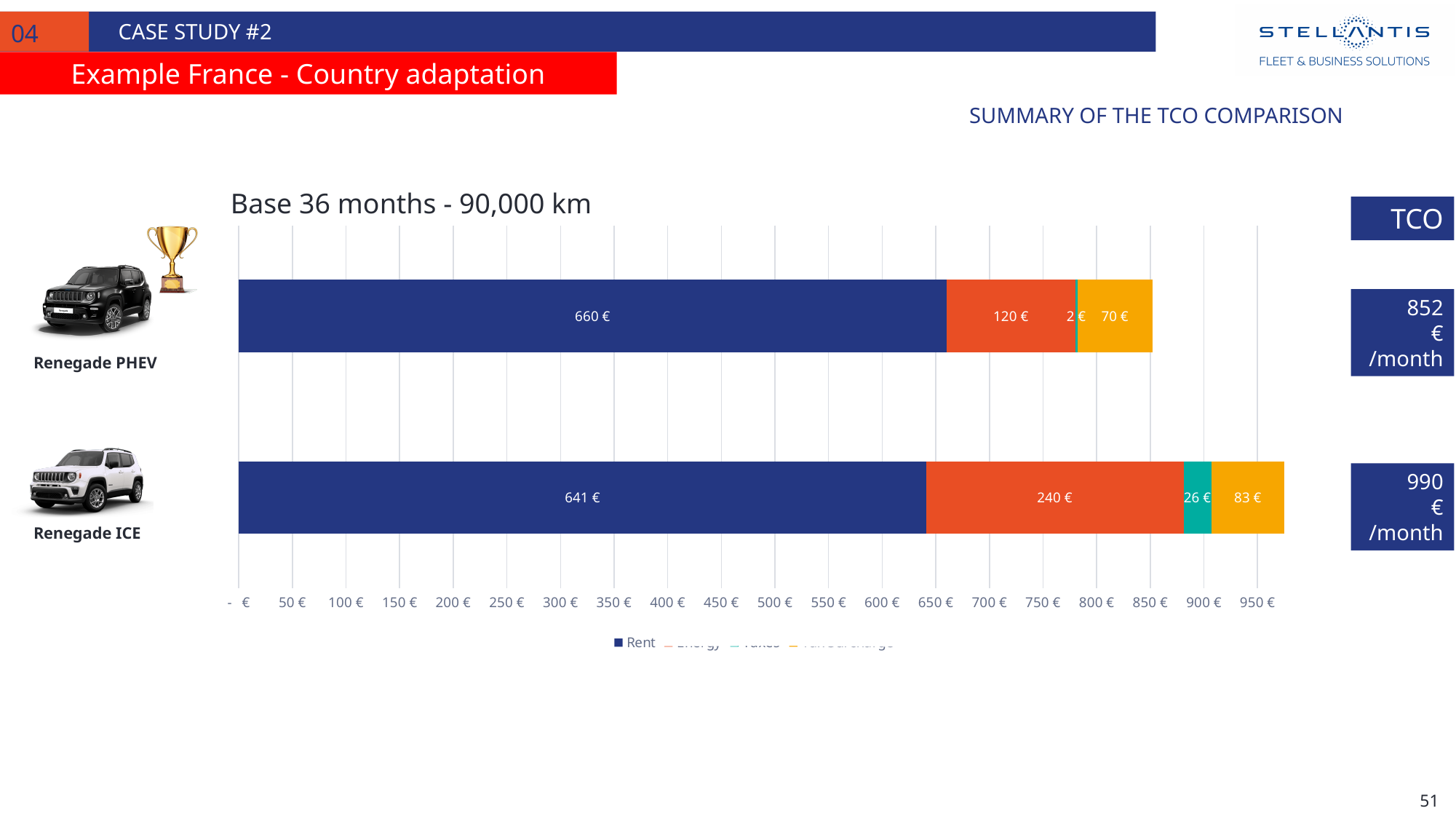
What is the title of the chart? Base 36 months - 90,000 km What is the value of the yellow segment for Renegade PHEV? 70 € What is the value of the blue (Rent) segment for Renegade ICE? 641 € What is the total of the stacked bar for Renegade PHEV? 852 € How many series does the chart legend list? 4 How many vehicle categories are plotted in the chart? 2 What is the value of the orange segment for Renegade ICE? 240 € What is the difference between the orange segments of Renegade ICE and Renegade PHEV? 120 € What kind of chart is shown on the slide? Stacked bar chart What is the value of the blue (Rent) segment for Renegade PHEV? 660 € Which vehicle has the longer total stacked bar? Renegade ICE What is the value of the teal segment for Renegade ICE? 26 €